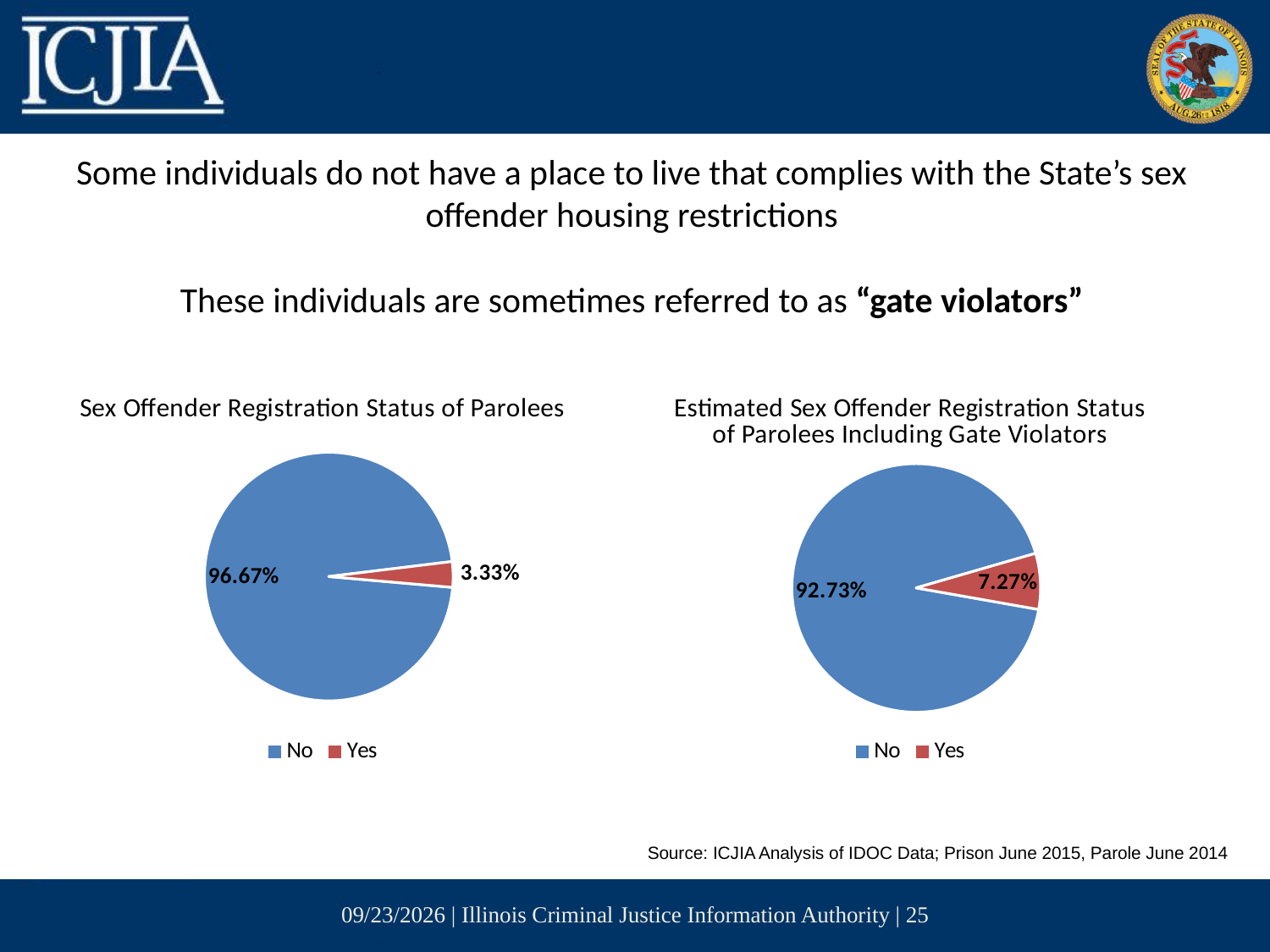
In the 'Sex Offender Registration Status of Parolees' pie chart, what share is labelled 'Yes'? 3.33% In the 'Sex Offender Registration Status of Parolees' pie chart, what share is labelled 'No'? 96.67% In the 'Estimated Sex Offender Registration Status of Parolees Including Gate Violators' pie chart, what share is labelled 'No'? 92.73% In the left pie chart, which category has the largest slice? No What kind of chart is used on the left side of the slide? Pie chart What is the difference between the 'No' share in the left pie chart and the 'No' share in the right pie chart? 3.94% How many slices does the 'Sex Offender Registration Status of Parolees' pie chart have? 2 In the right pie chart, which category has the smallest slice? Yes What colour represents 'Yes' in both pie charts? Red Which chart shows a larger 'Yes' share: the left pie chart or the right pie chart? The right pie chart In the 'Estimated Sex Offender Registration Status of Parolees Including Gate Violators' pie chart, what share is labelled 'Yes'? 7.27% How many entries does the legend of the right pie chart list? 2